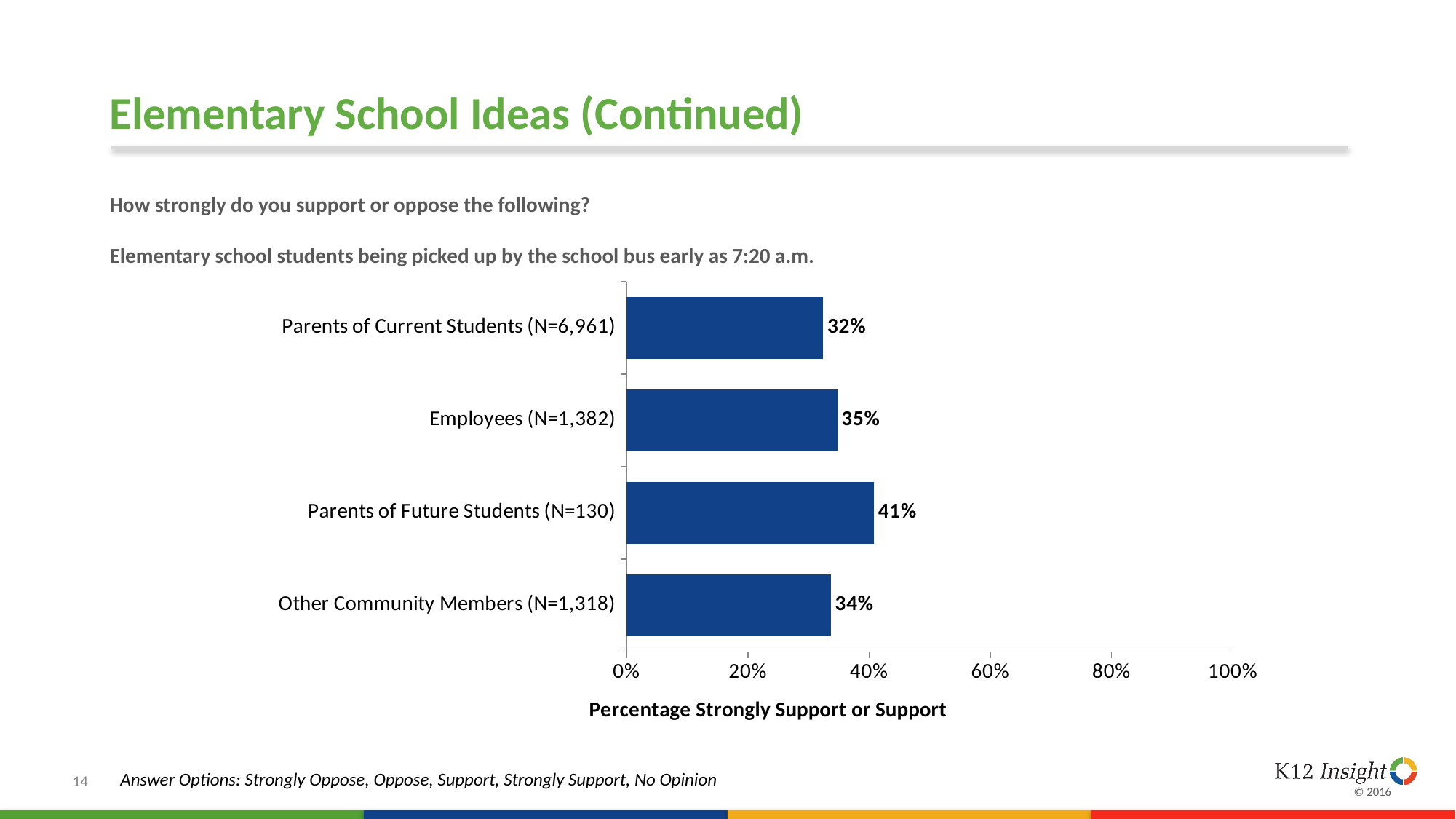
What is the value for Employees (N=1,382)? 35% Is the value for Parents of Future Students greater or less than 40%? greater What is the difference between the values for Parents of Future Students and Parents of Current Students? 9% Which group has the lowest percentage of strongly support or support? Parents of Current Students (N=6,961) What is the label of the horizontal axis of the chart? Percentage Strongly Support or Support Which group has the highest percentage of strongly support or support? Parents of Future Students (N=130) What is the value for Parents of Future Students (N=130)? 41% What is the value for Other Community Members (N=1,318)? 34% What kind of chart is shown on the slide? Bar chart How many respondent groups are shown in the chart? 4 What percentage of Parents of Current Students strongly support or support elementary school students being picked up by the school bus as early as 7:20 a.m.? 32% Which is larger, the value for Employees or the value for Other Community Members? Employees